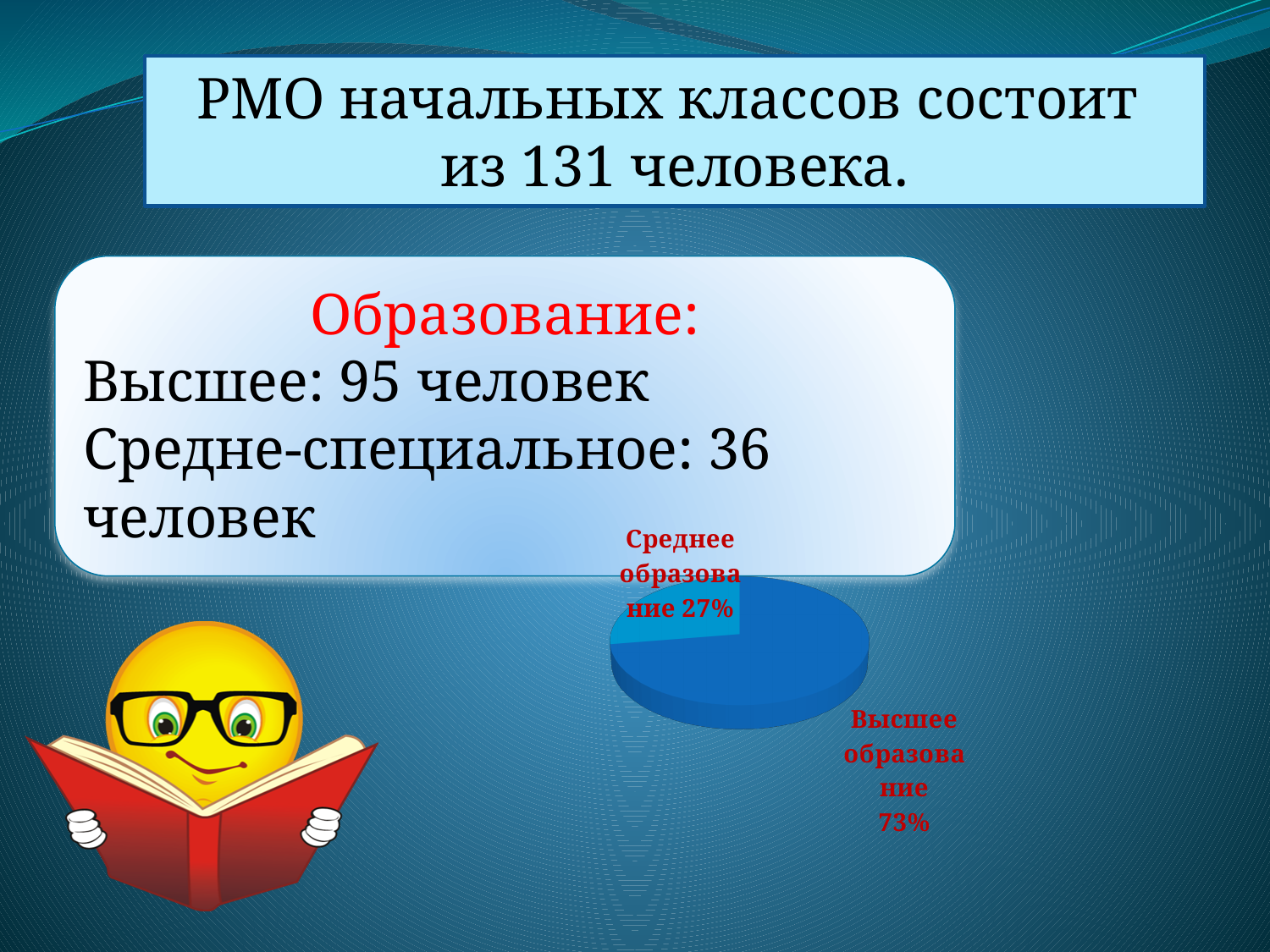
Which is larger in the pie chart, "Высшее образование" or "Среднее образование"? Высшее образование Which slice of the pie chart is the largest? Высшее образование What is the value shown for "Высшее образование" in the pie chart? 73% What share of the pie does "Среднее образование" take? 27% In what colour are the data labels of the pie chart written? red What colour is the "Среднее образование" slice of the pie chart? light blue What is the difference in percentage points between "Высшее образование" and "Среднее образование" in the pie chart? 46% What share of the pie does "Высшее образование" take? 73% Which slice of the pie chart is the smallest? Среднее образование What is the value shown for "Среднее образование" in the pie chart? 27% How many slices does the pie chart have? 2 What kind of chart is shown on the slide? pie chart